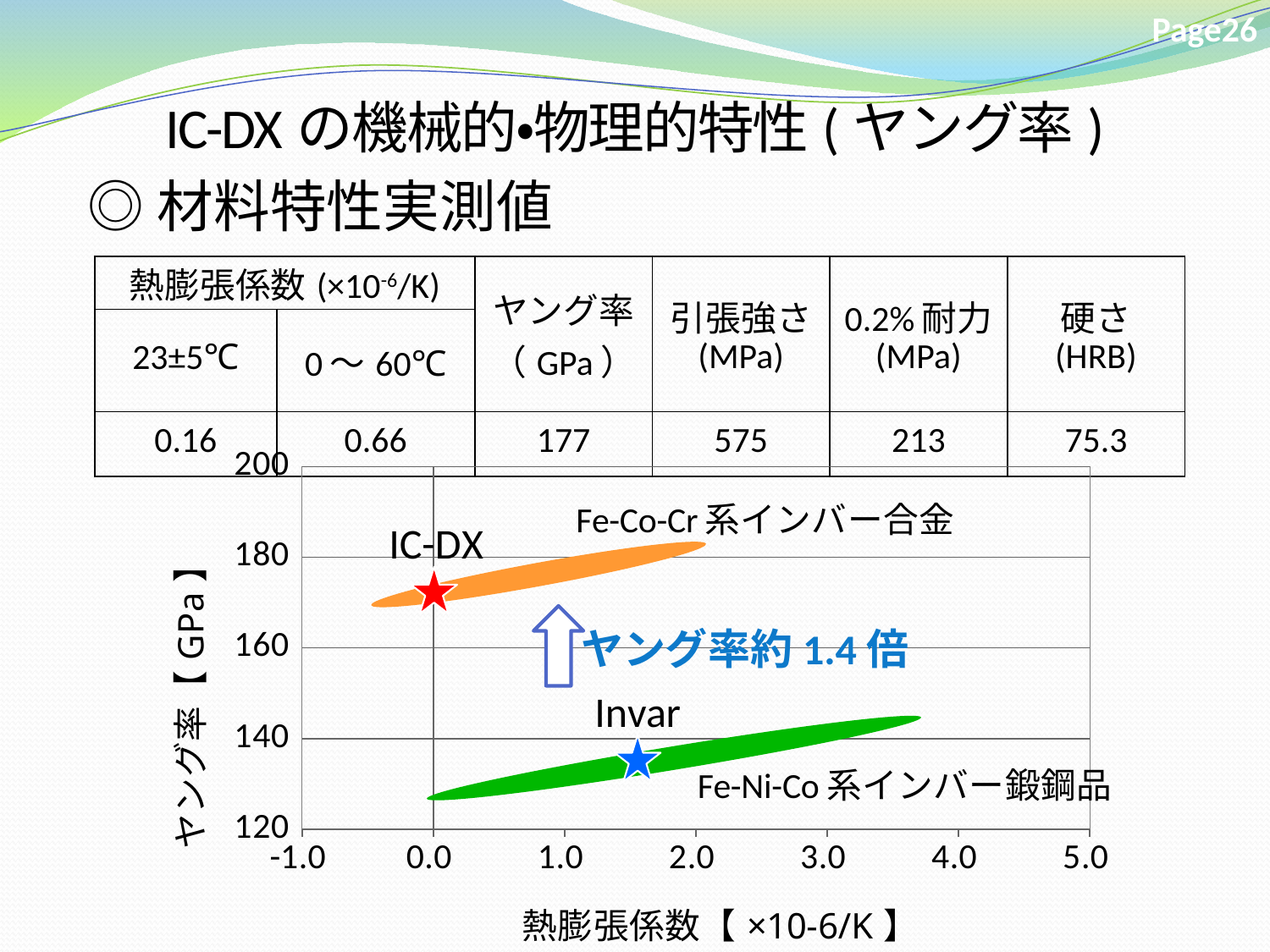
What kind of chart is shown on the slide? scatter chart Is the Young's modulus value for Invar greater or less than 120 GPa? greater Is the thermal expansion coefficient (熱膨張係数) for Invar greater or less than 1.0? greater How many labelled star points are plotted on the chart? 2 Is the thermal expansion coefficient (熱膨張係数) for IC-DX greater or less than 1.0? less Which labelled point has the highest Young's modulus (ヤング率) on the chart? IC-DX What is the label of the y axis of the chart? ヤング率【GPa】 Which of the two labelled points, IC-DX or Invar, has the higher Young's modulus (ヤング率)? IC-DX Which labelled point has the lowest Young's modulus (ヤング率) on the chart? Invar